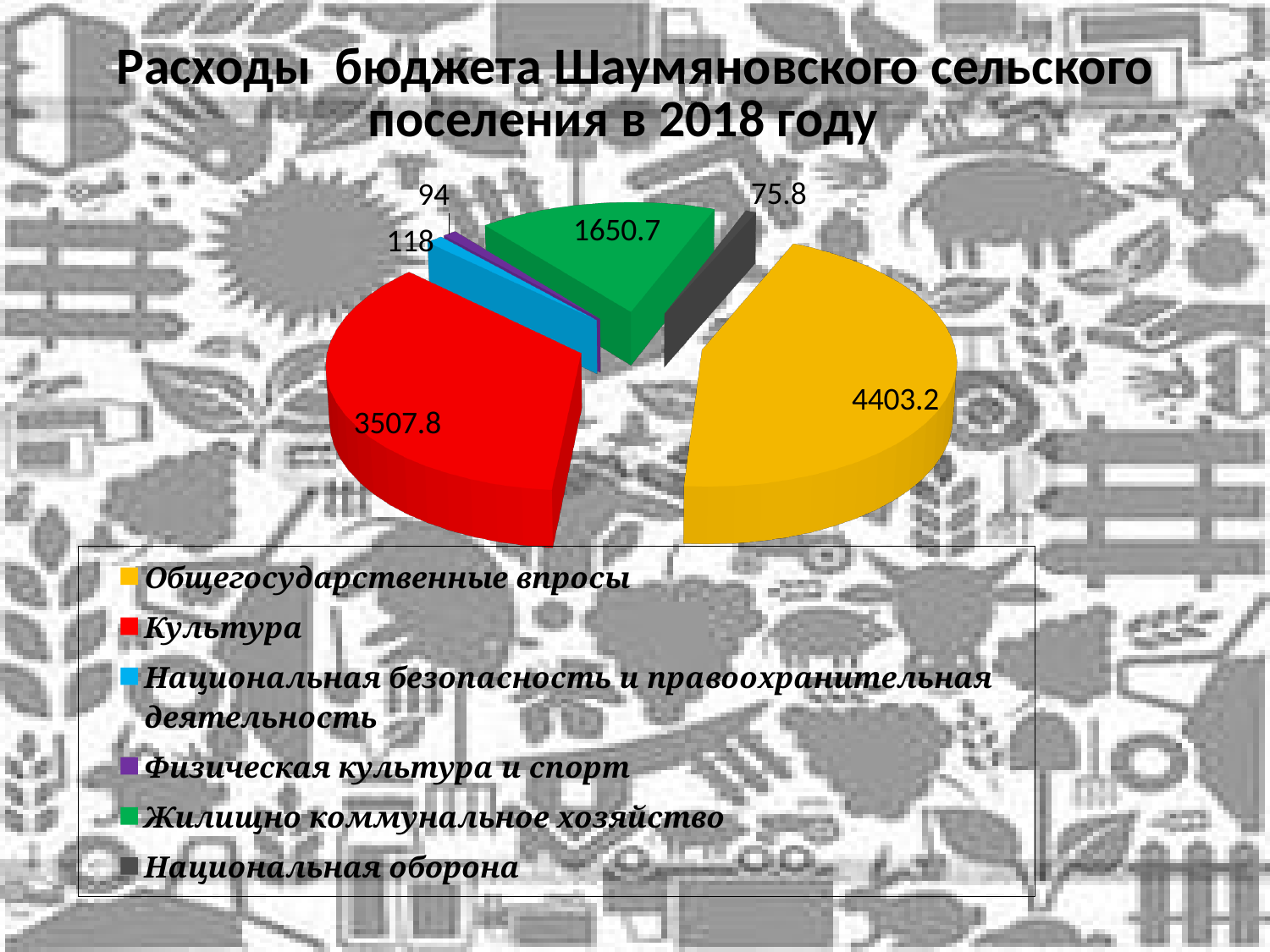
What colour is the slice for Культура? Red What is the value for Культура? 3507.8 Which category has the largest value? Общегосударственные впросы What is the title of the chart? Расходы бюджета Шаумяновского сельского поселения в 2018 году Which category has the smallest value? Национальная оборона What is the value for Физическая культура и спорт? 94 What is the difference between Общегосударственные впросы and Культура? 895.4 What kind of chart is shown on the slide? Pie chart How many categories are shown in the pie chart? 6 What is the value for Национальная оборона? 75.8 Which is larger, Национальная безопасность и правоохранительная деятельность or Физическая культура и спорт? Национальная безопасность и правоохранительная деятельность What is the value for Жилищно коммунальное хозяйство? 1650.7